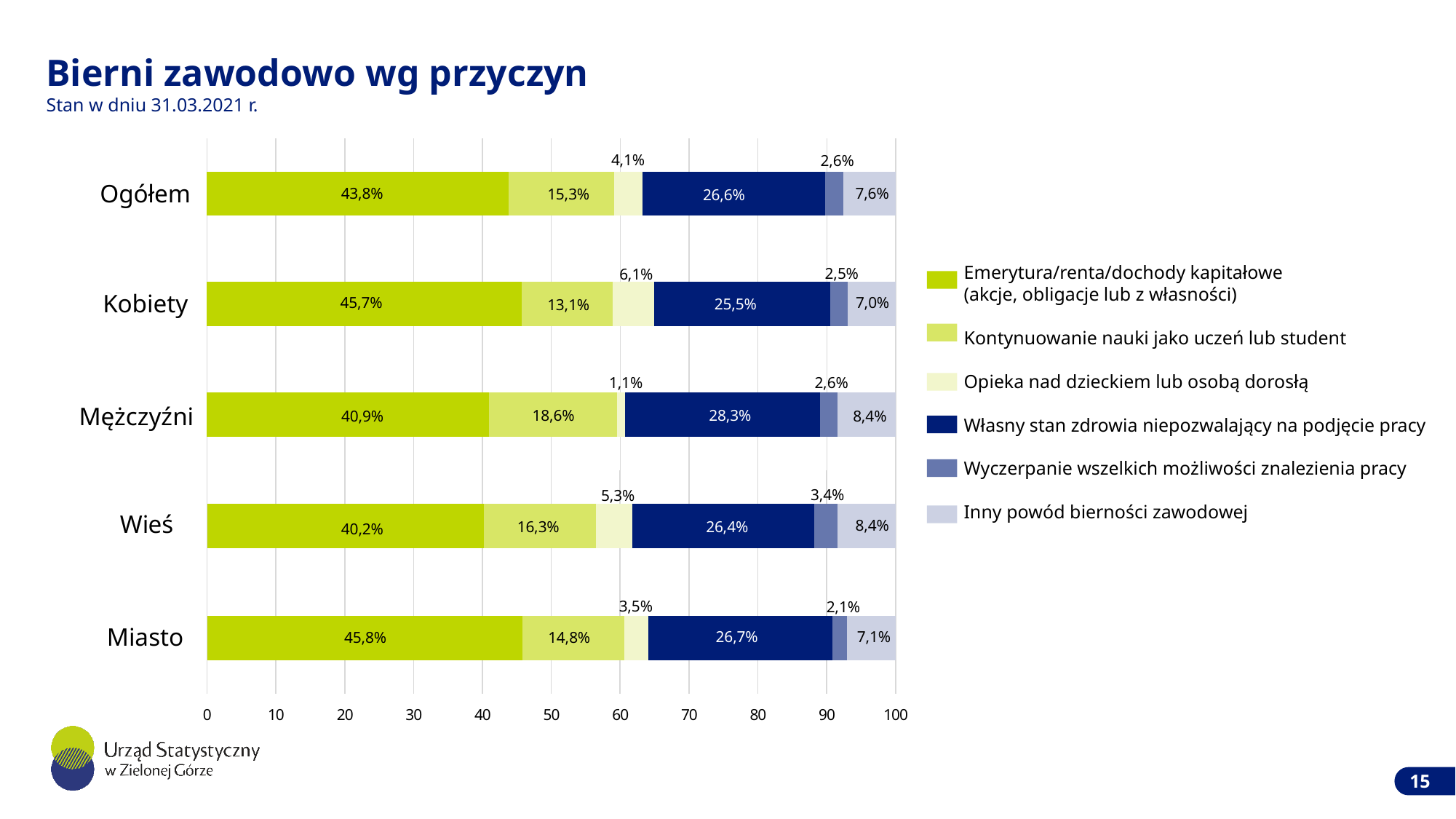
What kind of chart is shown on the slide? Stacked bar chart What is the total of the Ogółem stacked bar? 100,0% What is the value for Emerytura/renta/dochody kapitałowe in the Ogółem bar? 43,8% Which category has the lowest value for Opieka nad dzieckiem lub osobą dorosłą? Mężczyźni What is the value for Inny powód bierności zawodowej for Miasto? 7,1% What is the value for Własny stan zdrowia niepozwalający na podjęcie pracy for Mężczyźni? 28,3% Which category has the highest value for Kontynuowanie nauki jako uczeń lub student? Mężczyźni How many categories are shown on the y axis of the chart? 5 What is the value for Opieka nad dzieckiem lub osobą dorosłą for Kobiety? 6,1% What is the difference between Mężczyźni and Kobiety for Kontynuowanie nauki jako uczeń lub student? 5,5 percentage points Which is larger: the Wyczerpanie wszelkich możliwości znalezienia pracy value for Wieś or for Miasto? Wieś How many series does the legend list? 6